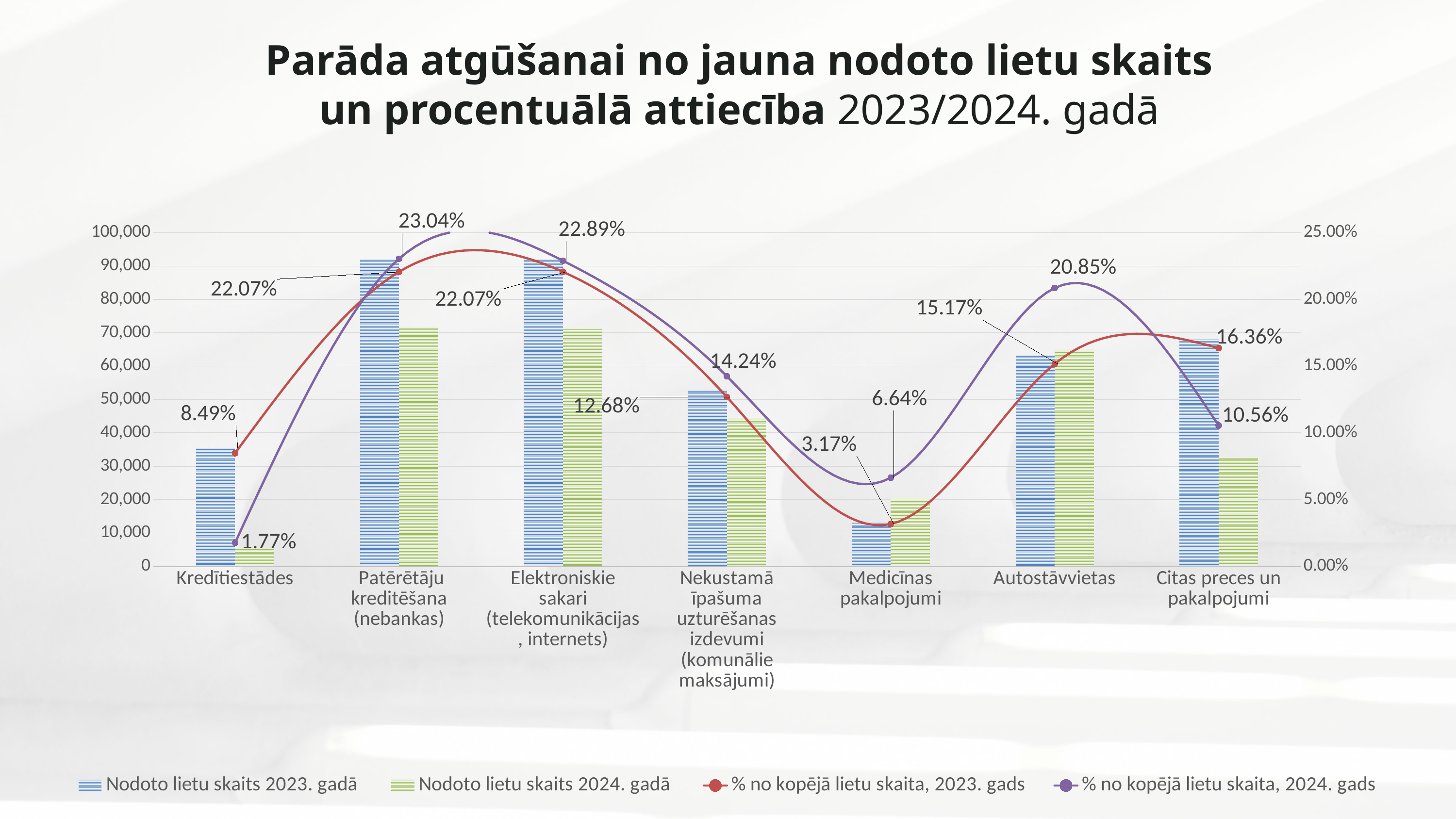
Is the value of "Nodoto lietu skaits 2023. gadā" for Kredītiestādes greater or less than 30,000? greater What is the value of "% no kopējā lietu skaita, 2024. gads" for Autostāvvietas? 20.85% Which category has the highest value for "% no kopējā lietu skaita, 2024. gads"? Patērētāju kreditēšana (nebankas) Is the value of "Nodoto lietu skaits 2024. gadā" for Medicīnas pakalpojumi greater or less than 30,000? less Which category has the lowest value for "% no kopējā lietu skaita, 2023. gads"? Medicīnas pakalpojumi How many series does the legend list? 4 How many categories are shown on the x axis? 7 What is the value of "% no kopējā lietu skaita, 2024. gads" for Kredītiestādes? 1.77% What is the difference between the 2024 percentage (20.85%) and the 2023 percentage (15.17%) for Autostāvvietas? 5.68 percentage points What is the value of "% no kopējā lietu skaita, 2023. gads" for Medicīnas pakalpojumi? 3.17% For Citas preces un pakalpojumi, which is larger: the 2023 percentage or the 2024 percentage? The 2023 percentage (16.36%) What kind of chart is shown on the slide? A combination bar and line chart